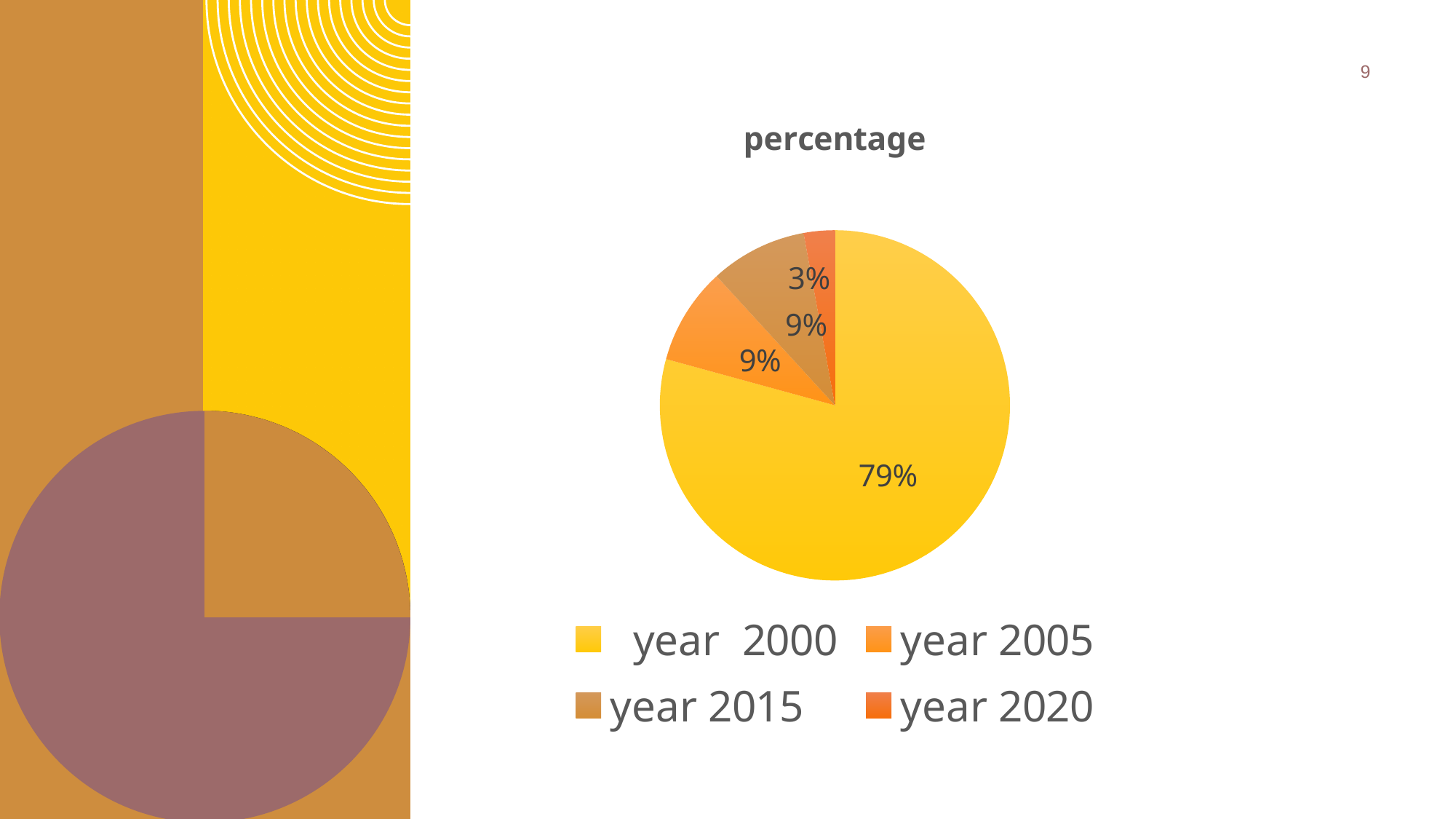
Which year has the largest share of the pie? year 2000 Which year has the smallest share of the pie? year 2020 What percentage does the year 2020 slice represent? 3% What type of chart is shown on the slide? pie chart What is the title of the chart? percentage What percentage does the year 2015 slice represent? 9% What is the difference between the year 2000 share and the year 2020 share? 76% How many slices does the pie chart have? 4 What percentage does the year 2005 slice represent? 9% How many entries does the legend list? 4 What percentage does the year 2000 slice represent? 79% Which is larger, the share for year 2005 or the share for year 2020? year 2005